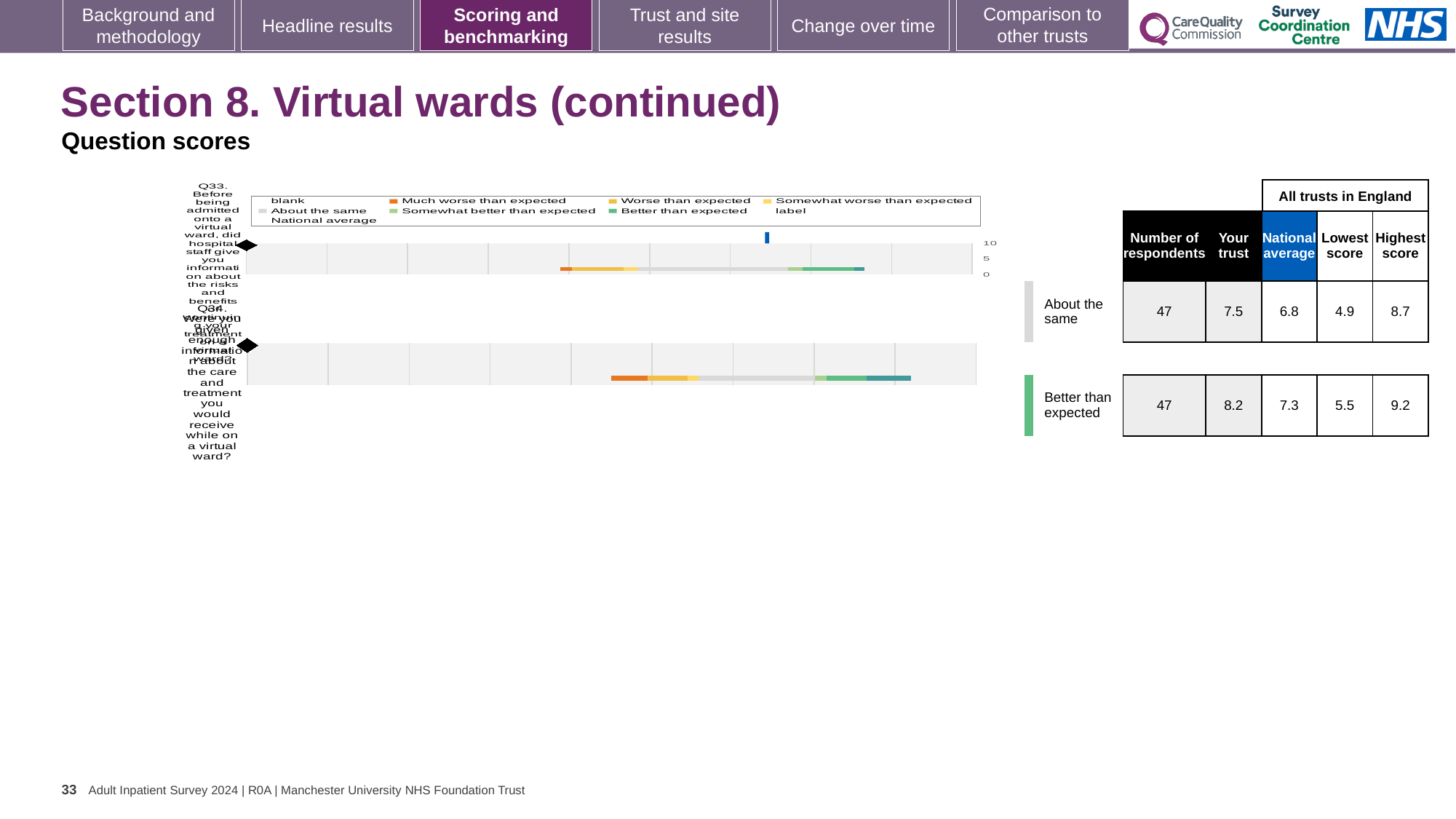
How many questions (rows) are plotted in the chart? 2 What is the national average score for Q33? 6.8 What is the highest score among all trusts in England for Q34? 9.2 How many entries does the chart legend list? 9 Which question has the higher 'Your trust' score, Q33 or Q34? Q34 What is the difference between the trust's score and the national average for Q34? 0.9 What is the 'Your trust' score for Q33 (information about the risks and benefits before being admitted onto a virtual ward)? 7.5 What is the lowest score among all trusts in England for Q33? 4.9 Which benchmark category is Q34 rated as? Better than expected What kind of chart is shown on the slide? bar chart How many respondents answered Q34? 47 What is the 'Your trust' score for Q34 (enough information about the care and treatment on a virtual ward)? 8.2